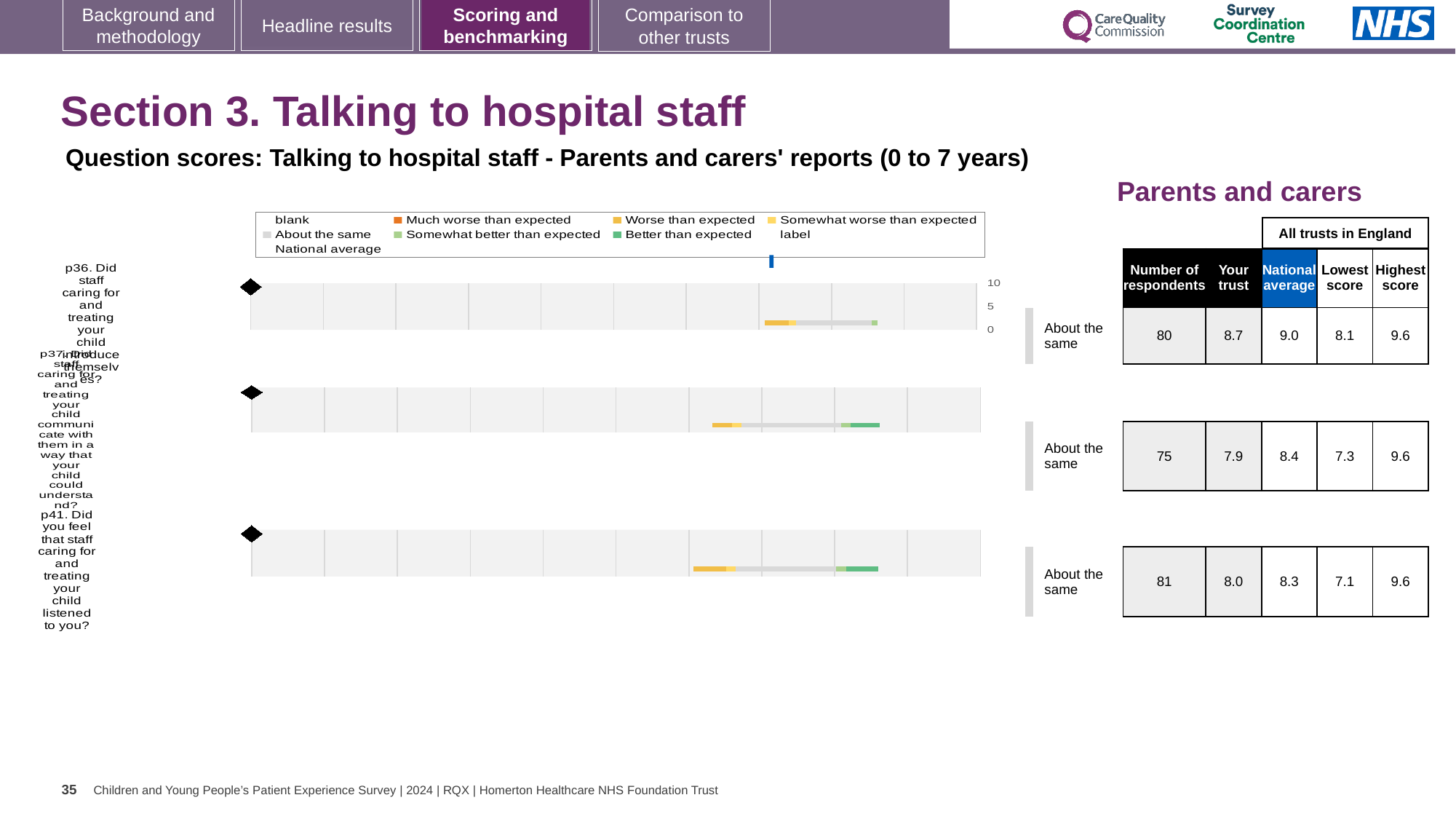
For the chart for p37 (Did staff communicate with them in a way that your child could understand?), what is the national average score? 8.4 What benchmark category is shown for the p41 chart? About the same What colour represents 'Better than expected' in the chart legend? Green Which of the three questions has the highest 'Your trust' score? p36 What is the highest value shown on the score axis of the charts? 10 How many question score charts are shown on the slide? 3 For p37, which is larger: the 'Your trust' score or the national average? National average For the chart for p36 (Did staff caring for and treating your child introduce themselves?), what is the 'Your trust' score? 8.7 Which of the three questions has the lowest 'Lowest score' across all trusts in England? p41 For p36, what is the difference between the national average and the 'Your trust' score? 0.3 What kind of chart is used to show the question scores on this slide? bar chart For the chart for p41 (Did you feel that staff caring for and treating your child listened to you?), how many respondents are there? 81